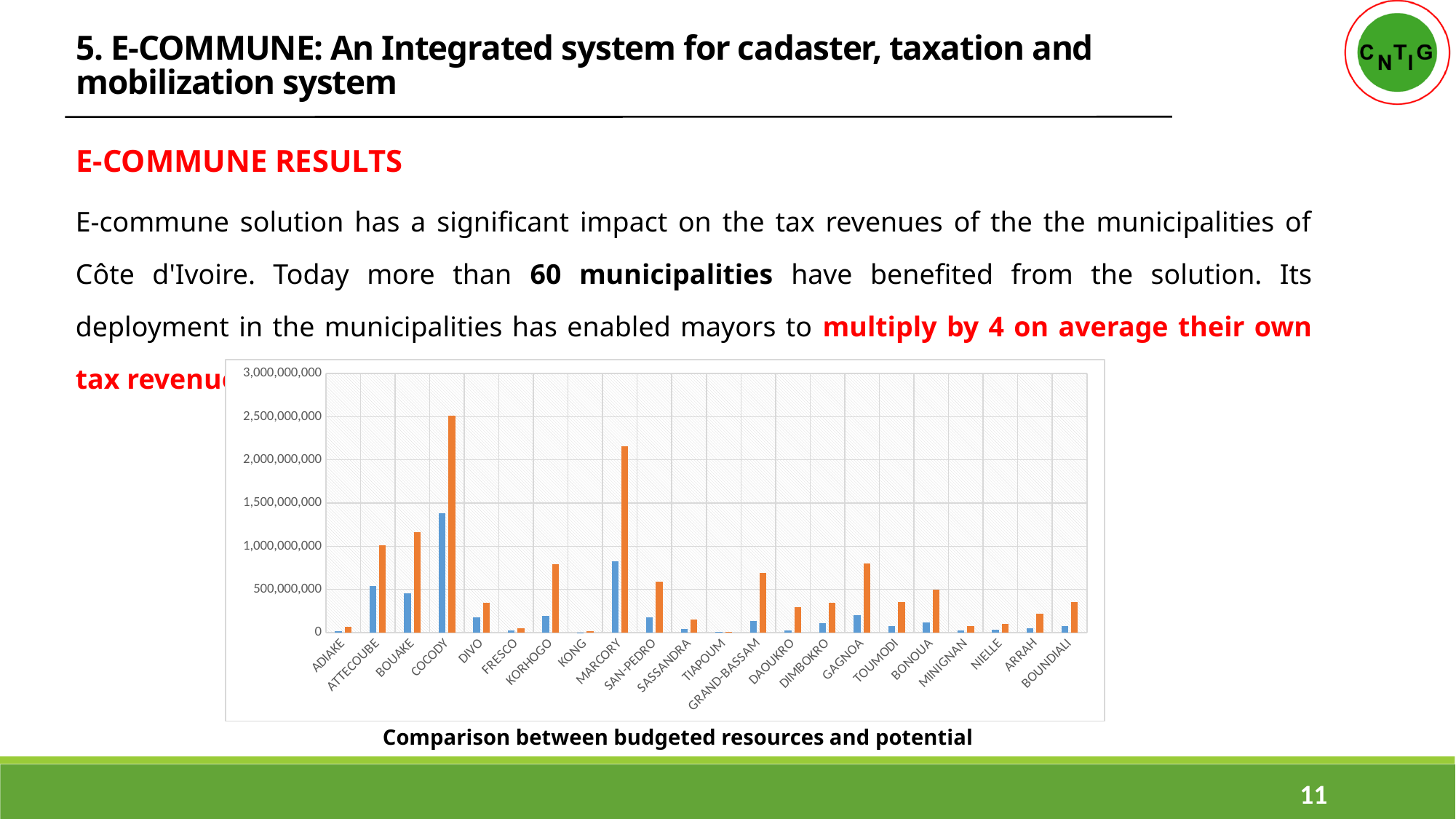
Is the orange bar for DIVO greater or less than 500,000,000? less Is the orange bar for COCODY greater or less than 2,000,000,000? greater What is the caption printed below the chart? Comparison between budgeted resources and potential Is the orange bar for MARCORY greater or less than 2,000,000,000? greater Which municipality has the tallest orange bar in the chart? COCODY Which municipality has the tallest blue bar in the chart? COCODY How many municipalities are shown on the x axis of the chart? 22 Which has the larger orange bar, COCODY or MARCORY? COCODY What kind of chart is shown on the slide? bar chart